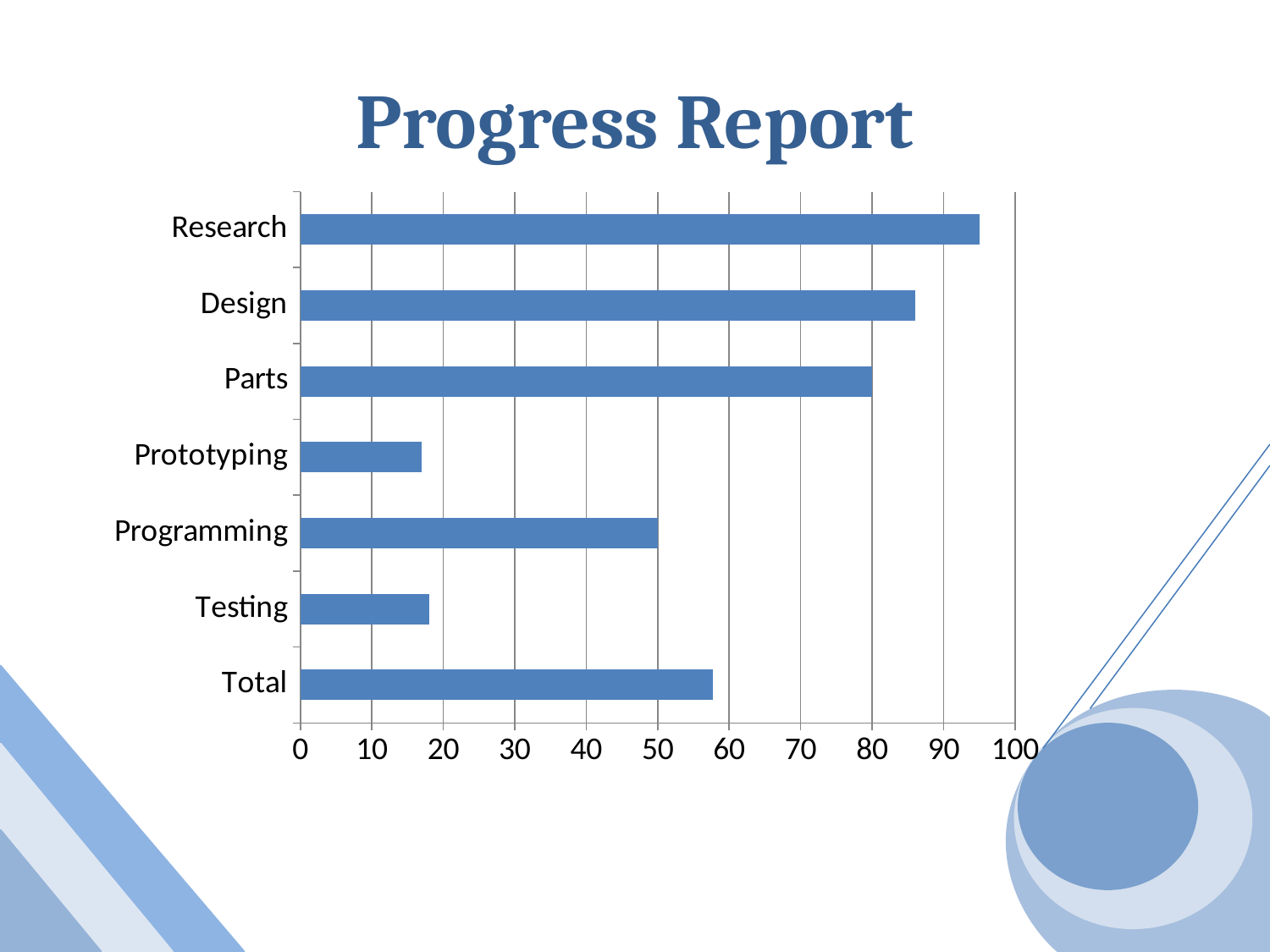
Is the value for Testing greater or less than 20? less Is the value for Research greater or less than 90? greater Which is larger, the value for Design or the value for Parts? Design What is the value for Programming? 50 How many categories are plotted in the chart? 7 Which category has the highest value? Research Which is larger, the value for Total or the value for Programming? Total What is the title of the chart? Progress Report What is the value for Parts? 80 Is the value for Total greater or less than 50? greater What kind of chart is shown on the slide? bar chart